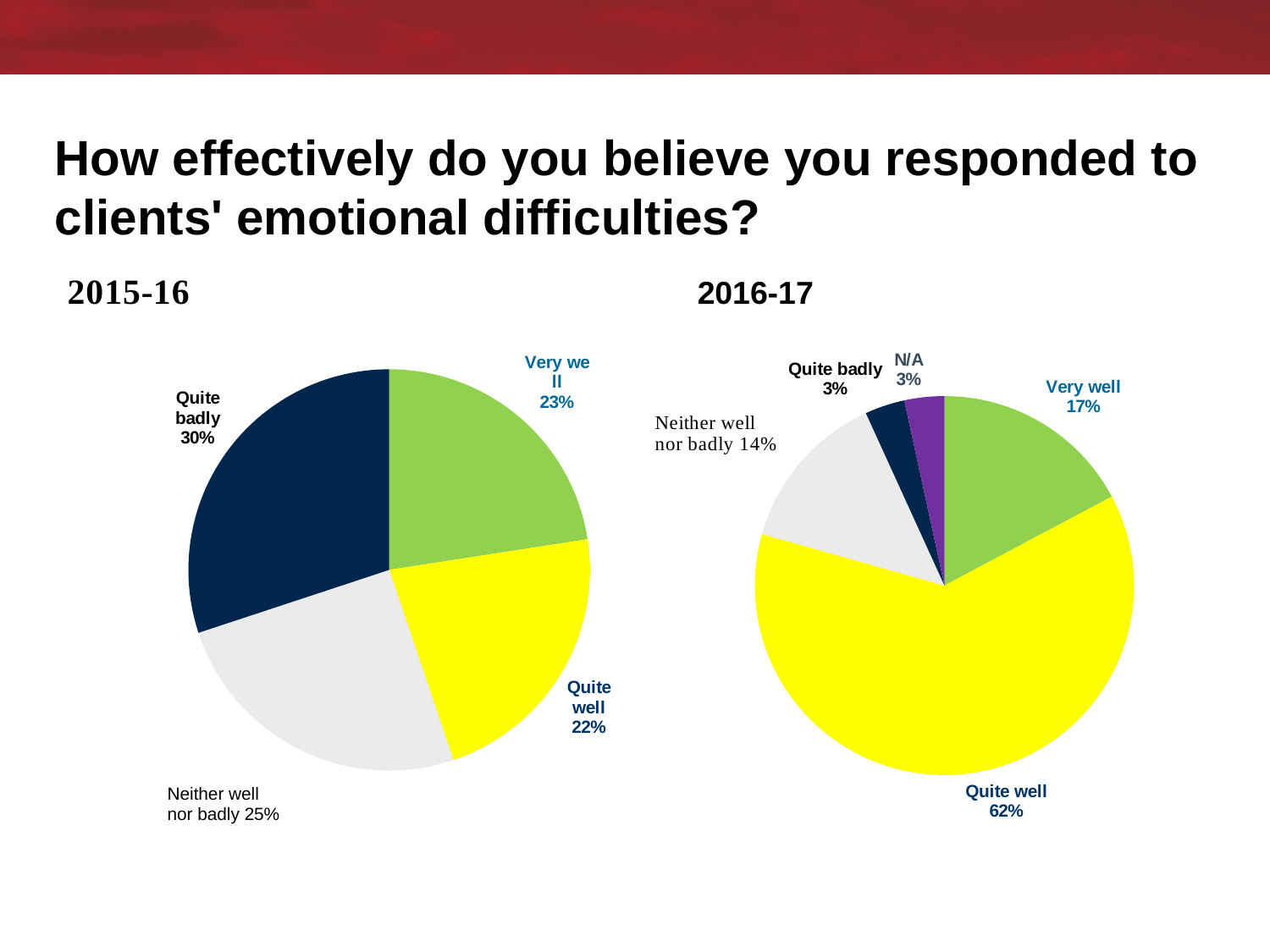
In the 2015-16 chart, what share of respondents answered 'Quite badly'? 30% In the 2015-16 chart, which response has the largest share? Quite badly In the 2016-17 chart, what is the difference between the 'Very well' share and the 'Neither well nor badly' share? 3 percentage points How many slices does the 2016-17 pie chart have? 5 In the 2016-17 chart, which response has the largest share? Quite well What type of chart is used on this slide? Pie chart In the 2016-17 chart, what share of respondents answered 'Quite well'? 62% In the 2016-17 chart, what share of respondents answered 'Very well'? 17% Which is larger: the 'Quite badly' share in 2015-16 or the 'Quite badly' share in 2016-17? 2015-16 In the 2015-16 chart, which response has the smallest share? Quite well What is the difference between the 'Quite well' share in 2016-17 and the 'Quite well' share in 2015-16? 40 percentage points In the 2015-16 chart, what share of respondents answered 'Neither well nor badly'? 25%